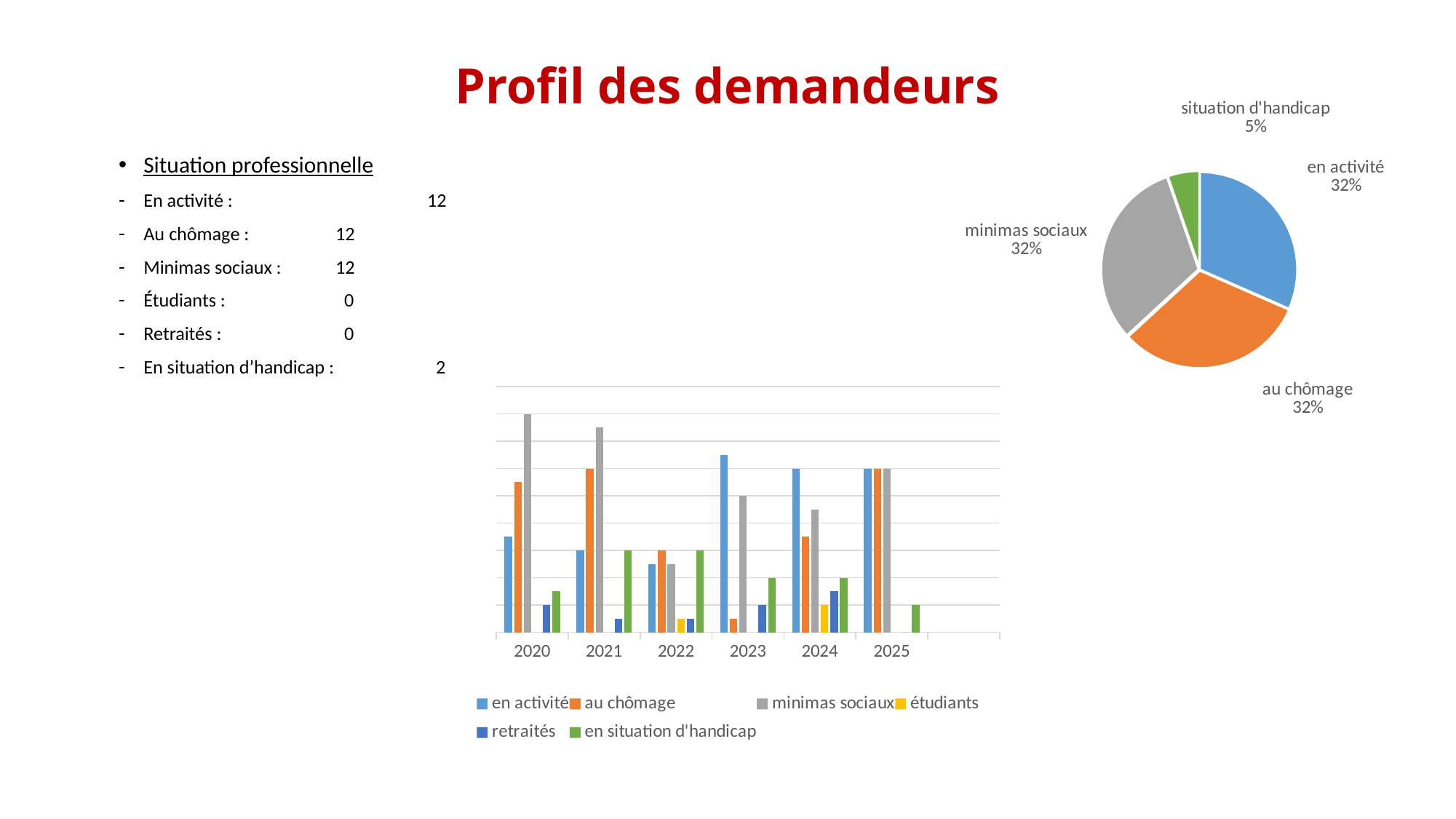
In the pie chart, what share does 'situation d'handicap' represent? 5% In the bar chart, for 2021, is the bar for 'au chômage' or the bar for 'en activité' taller? au chômage In the bar chart, how many series does the legend list? 6 In the bar chart, which colour represents 'étudiants' in the legend? yellow In the pie chart, what share does 'en activité' represent? 32% In the bar chart, how many years are shown on the x axis? 6 What kind of chart is the chart in the centre of the slide with years on the x axis? bar chart How many slices does the pie chart have? 4 In the pie chart, which slice is the smallest? situation d'handicap What kind of chart is the chart in the top right of the slide? pie chart In the bar chart, which series has the tallest bar for 2023? en activité In the bar chart, which series has the tallest bar for 2020? minimas sociaux